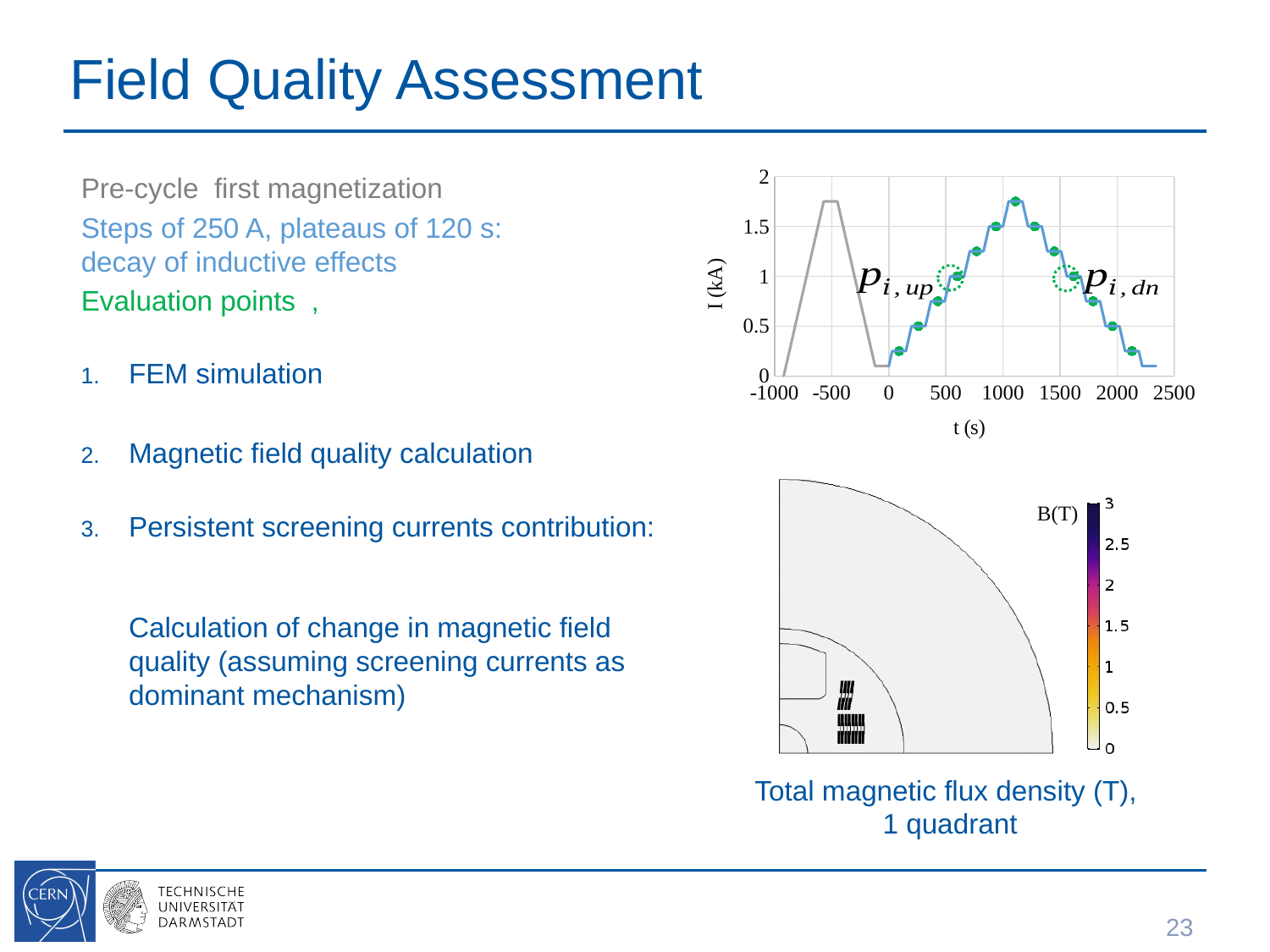
In the lower-right field plot, what is the maximum value shown on the B(T) colour bar? 3 In the upper-right chart, does the blue current curve rise or fall between t = 1500 s and t = 2000 s? fall In the lower-right field plot, what is the minimum value shown on the B(T) colour bar? 0 In the upper-right chart, does the blue current curve rise or fall between t = 0 s and t = 1000 s? rise In the upper-right chart, what is the smallest value shown on the x axis? -1000 In the upper-right chart, what is the highest tick value on the y axis? 2 In the upper-right chart, is the current of the blue curve at t = 0 s greater or less than 0.5 kA? less In the upper-right chart, what is the largest value shown on the x axis? 2500 In the upper-right chart, what is the label of the y axis? I (kA) What kind of chart is the plot in the upper right of the slide? line chart In the upper-right chart, is the peak current of the blue curve greater or less than 1.5 kA? greater In the upper-right chart, what is the label of the x axis? t (s)